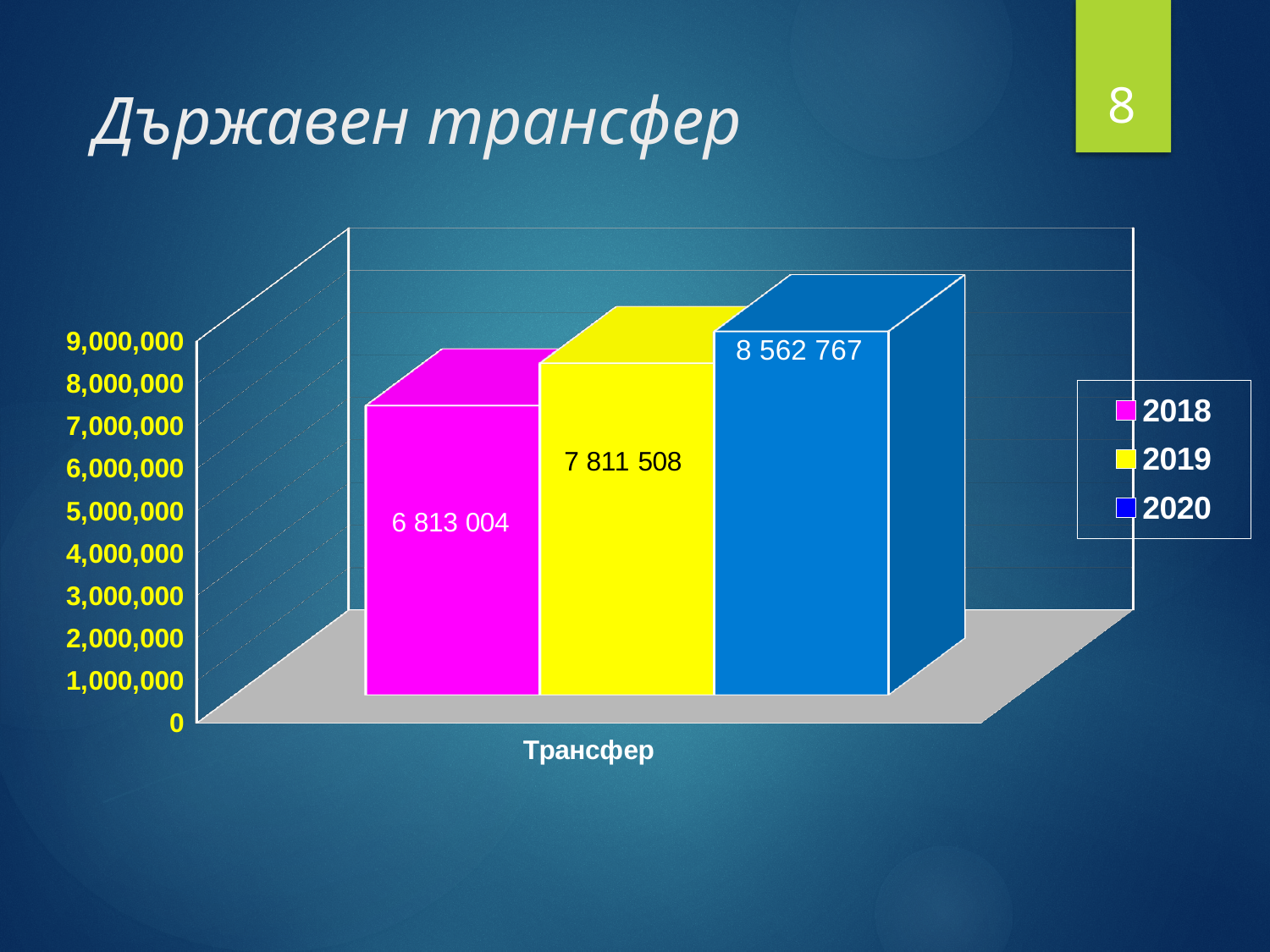
What is the value for 2018 in the Държавен трансфер chart? 6 813 004 Which year has the lowest value in the chart? 2018 How many series does the legend list? 3 What is the difference between the 2020 and 2019 values? 751 259 What is the value for 2020 in the Държавен трансфер chart? 8 562 767 What is the category label shown on the x axis of the chart? Трансфер What kind of chart is shown on the slide? Bar chart Which year has the highest value in the chart? 2020 Do the values rise or fall from 2018 to 2020? Rise What is the difference between the 2019 and 2018 values? 998 504 What is the value for 2019 in the Държавен трансфер chart? 7 811 508 Which is larger, the value for 2018 or the value for 2020? 2020